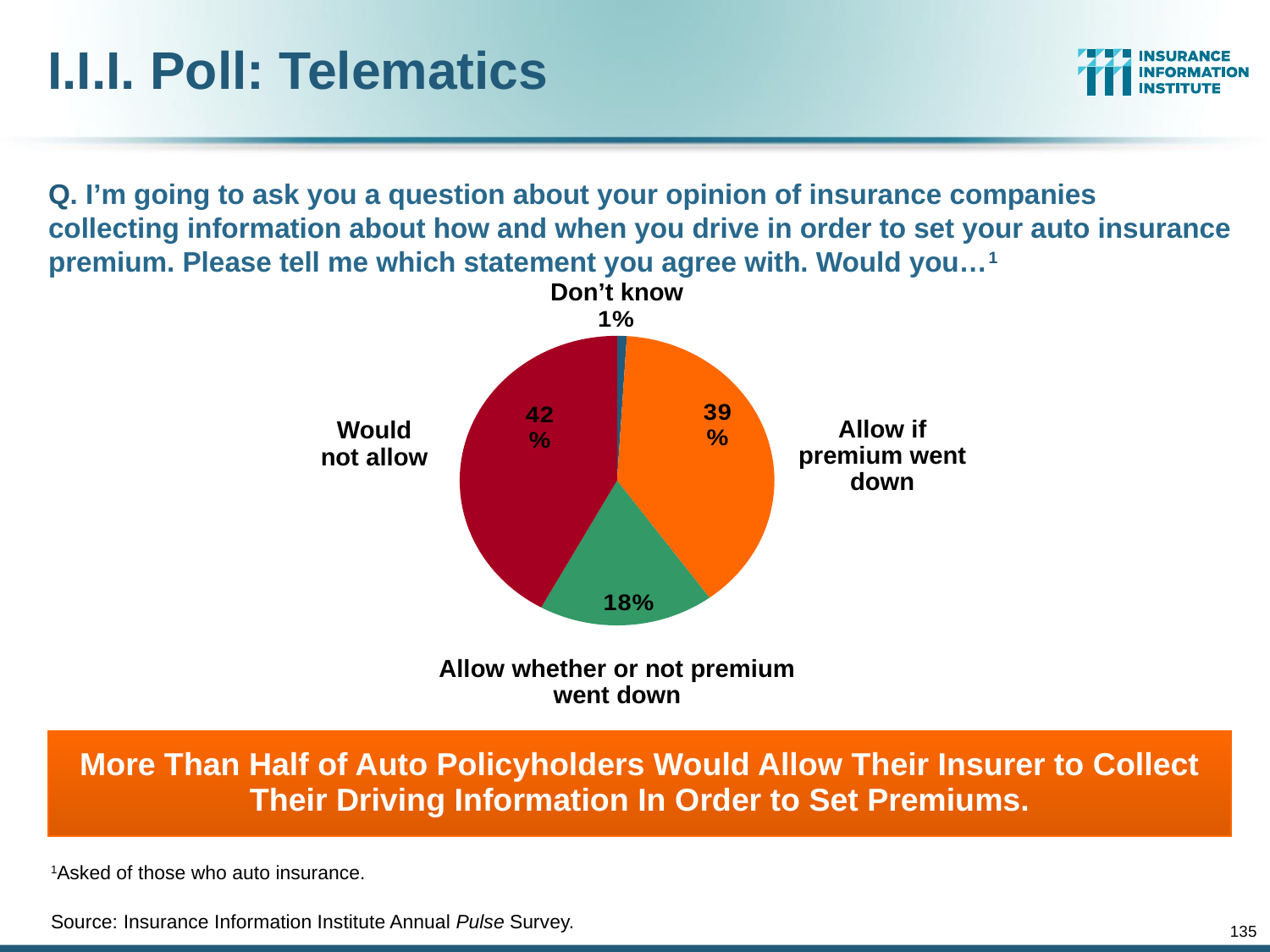
What percentage of respondents would allow it if their premium went down? 39% What percentage of respondents answered 'Don't know'? 1% What percentage of respondents said they would not allow insurers to collect driving information? 42% What is the difference in percentage points between 'Would not allow' and 'Allow if premium went down'? 3 What percentage of respondents would allow it whether or not their premium went down? 18% How many slices does the pie chart have? 4 What is the combined percentage of respondents who would allow collection, either if premium went down or whether or not it went down? 57% What kind of chart is shown on the slide? pie chart Which response has the smallest share of the pie? Don't know Which is larger: the share for 'Allow if premium went down' or the share for 'Allow whether or not premium went down'? Allow if premium went down Which response has the largest share of the pie? Would not allow What colour is the 'Would not allow' slice? dark red